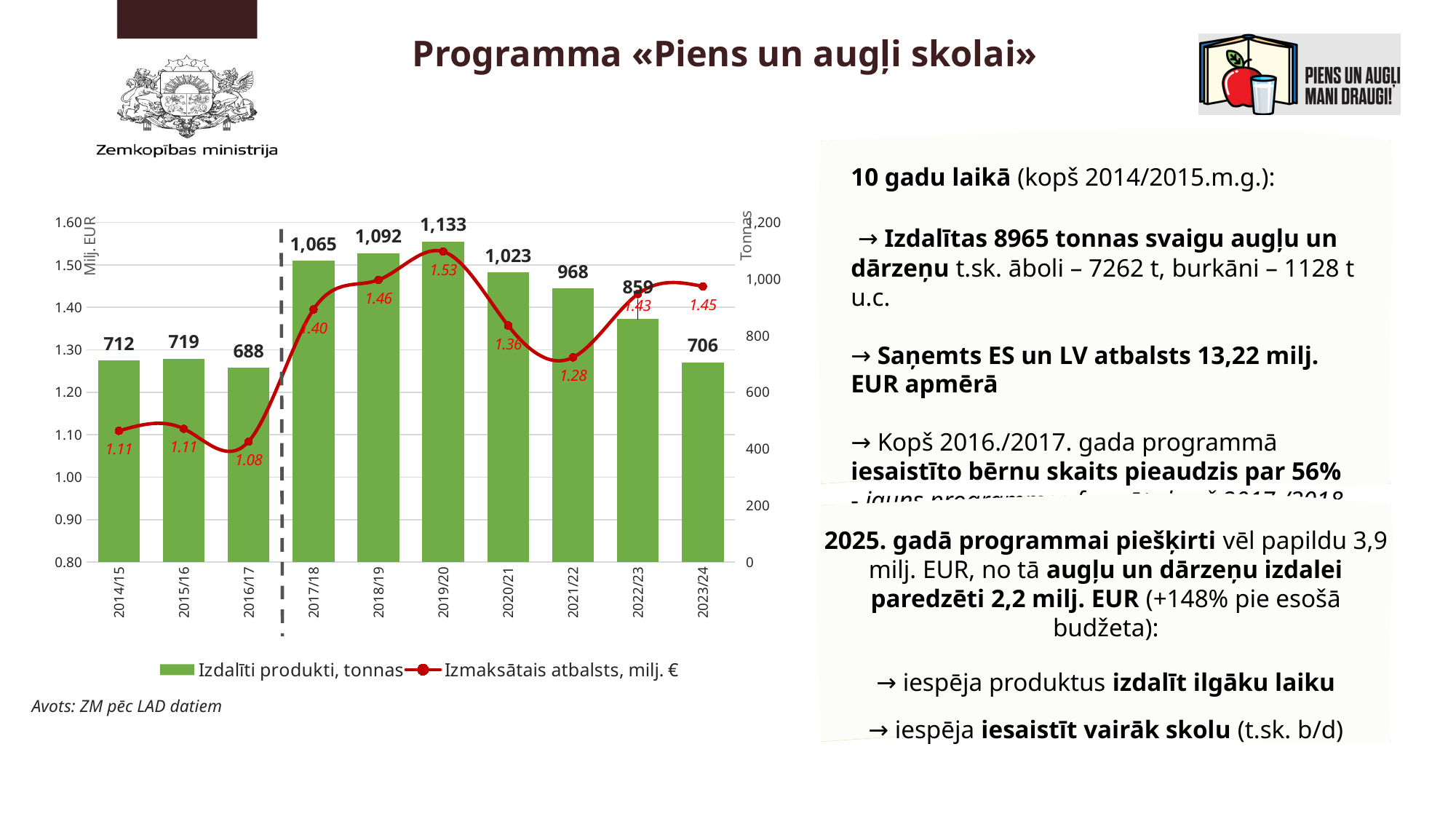
How many school years are shown on the x axis of the chart? 10 How many series does the chart legend list? 2 Is the value for Izdalīti produkti, tonnas in 2022/23 greater or less than 800? greater How many tonnes of products (Izdalīti produkti, tonnas) were distributed in 2019/20? 1,133 Which school year has the lowest value for Izmaksātais atbalsts, milj. €? 2016/17 What is the label of the right-hand vertical axis of the chart? Tonnas What is the difference in tonnes distributed between 2019/20 and 2023/24? 427 Which year had more tonnes distributed, 2017/18 or 2020/21? 2017/18 What was the support paid (Izmaksātais atbalsts, milj. €) in 2021/22? 1.28 Which school year has the lowest value for Izdalīti produkti, tonnas? 2016/17 Which school year has the highest value for Izdalīti produkti, tonnas? 2019/20 What kind of chart is used to show Izdalīti produkti, tonnas? Bar chart